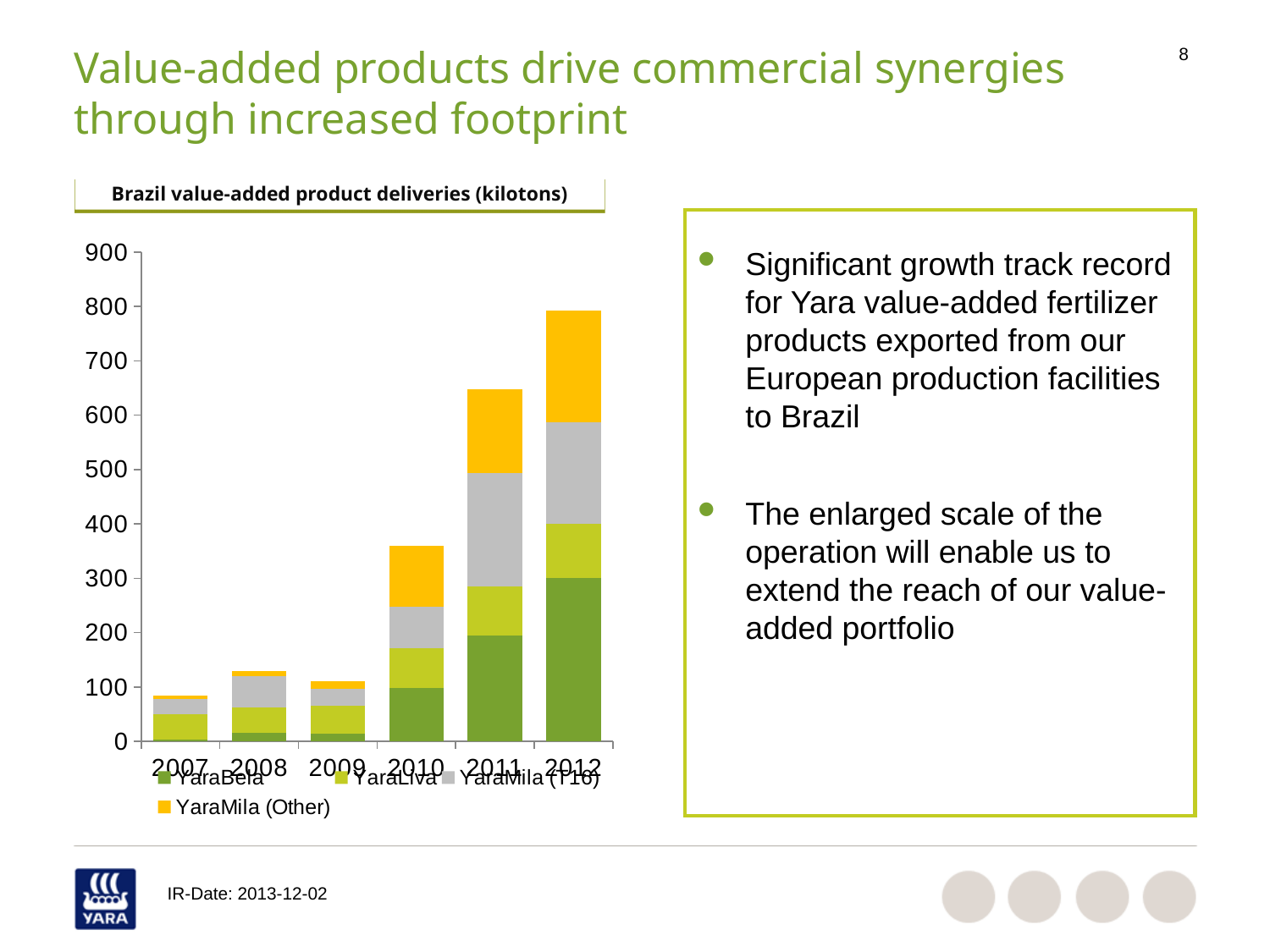
Which series is shown in yellow in the chart legend? YaraMila (Other) Which year has the larger total deliveries, 2010 or 2011? 2011 Is the total value for 2012 greater or less than 700? greater How many series does the chart legend list? 4 What is the title of the chart? Brazil value-added product deliveries (kilotons) Is the total value for 2010 greater or less than 400? less What kind of chart is shown on the slide? Stacked bar chart Which year has the lowest total deliveries in the chart? 2007 How many years are shown on the x axis of the chart? 6 Which year has the highest total deliveries in the chart? 2012 Do total deliveries generally rise or fall from 2007 to 2012? rise Is the total value for 2007 greater or less than 100? less